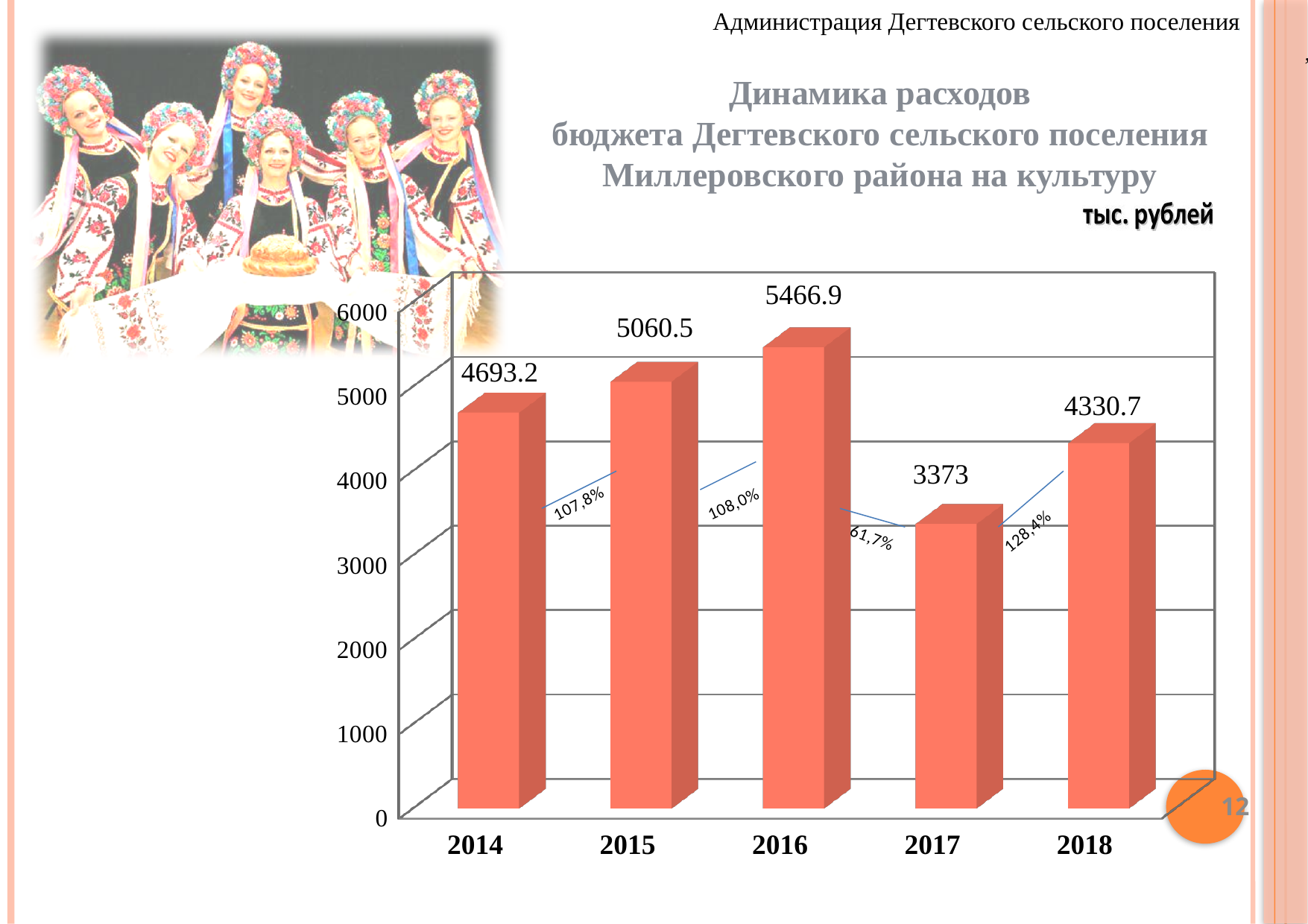
What is the value for 2014? 4693.2 Is the value for 2017 greater or less than 4000? less What unit is stated above the chart? тыс. рублей What is the value for 2016? 5466.9 What is the difference between the values for 2016 and 2017? 2093.9 How many years are shown on the x axis? 5 What is the value for 2018? 4330.7 Which year has the lowest value? 2017 What is the value for 2017? 3373 Which is larger, the value for 2015 or the value for 2018? 2015 What kind of chart is shown on the slide? bar chart Which year has the highest value? 2016